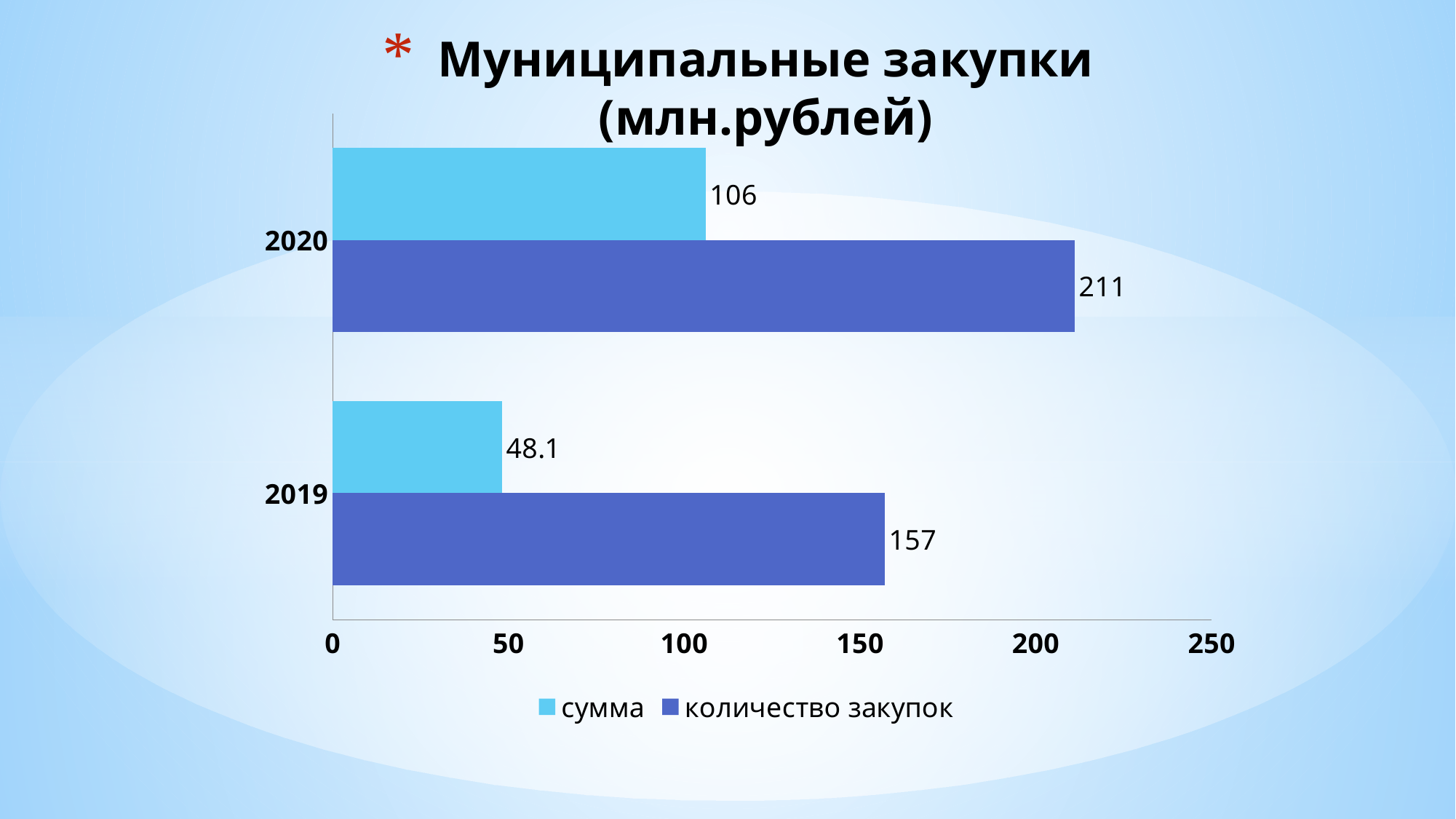
What is the value of сумма for 2020? 106 What is the value of количество закупок for 2020? 211 What is the difference between сумма in 2020 and in 2019? 57.9 Is сумма for 2020 larger or smaller than количество закупок for 2019? smaller What is the difference between количество закупок in 2020 and in 2019? 54 Which year has the higher value for количество закупок? 2020 What kind of chart is shown on the slide? bar chart What is the title of the chart? Муниципальные закупки (млн.рублей) How many series does the legend list? 2 What is the value of количество закупок for 2019? 157 What is the value of сумма for 2019? 48.1 Which year has the lower value for сумма? 2019